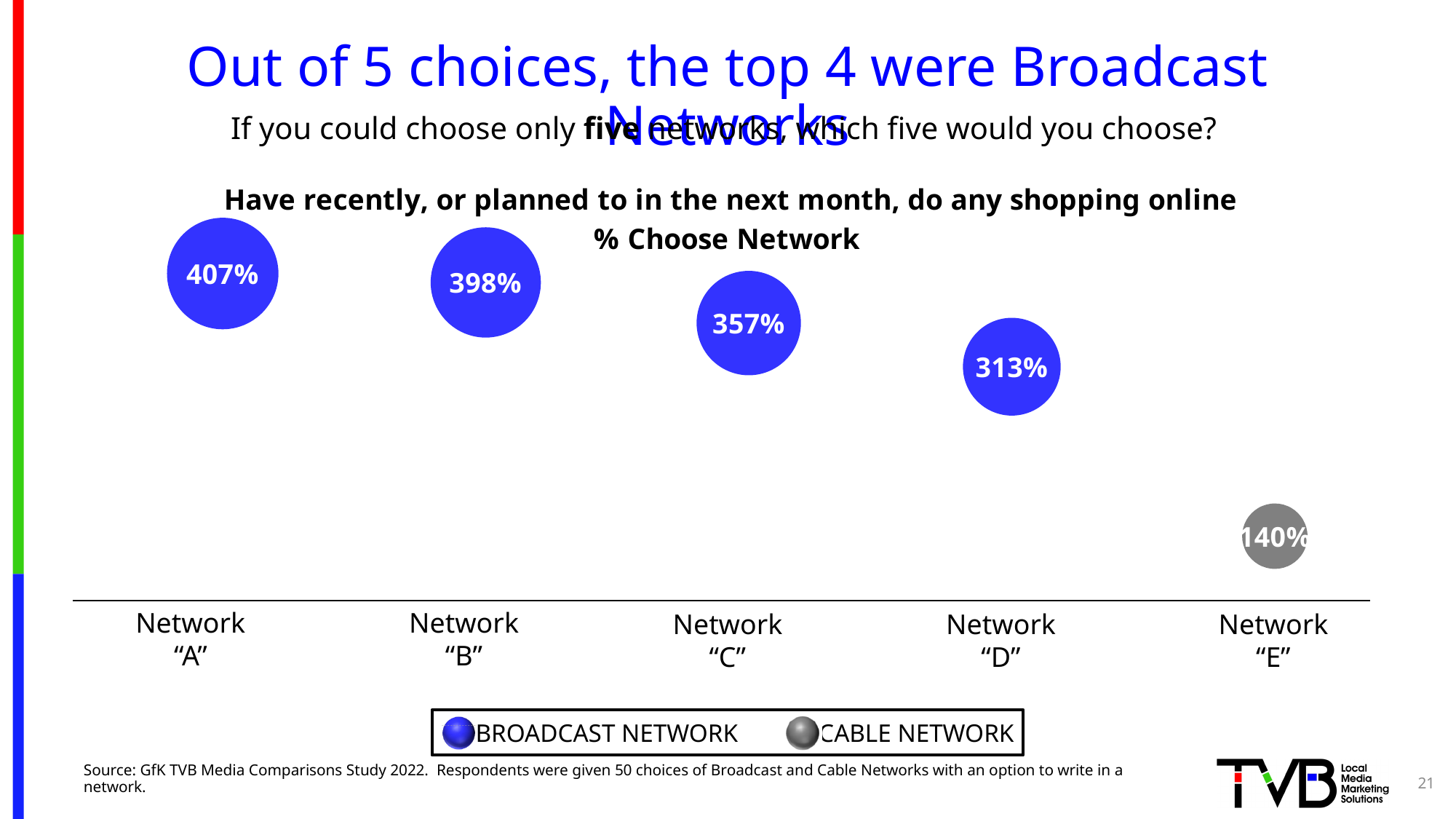
Which network is shown as a Cable Network in the chart? Network "E" What is the value for Network "E"? 140% Do the values rise or fall from Network "A" to Network "E"? fall How many series does the legend list? 2 What is the difference between the values for Network "A" and Network "E"? 267% Which network has the lowest value? Network "E" What is the value for Network "A"? 407% How many networks are shown on the chart? 5 Which has a larger value, Network "C" or Network "D"? Network "C" What is the difference between the values for Network "B" and Network "D"? 85% What is the value for Network "C"? 357% Which network has the highest value? Network "A"